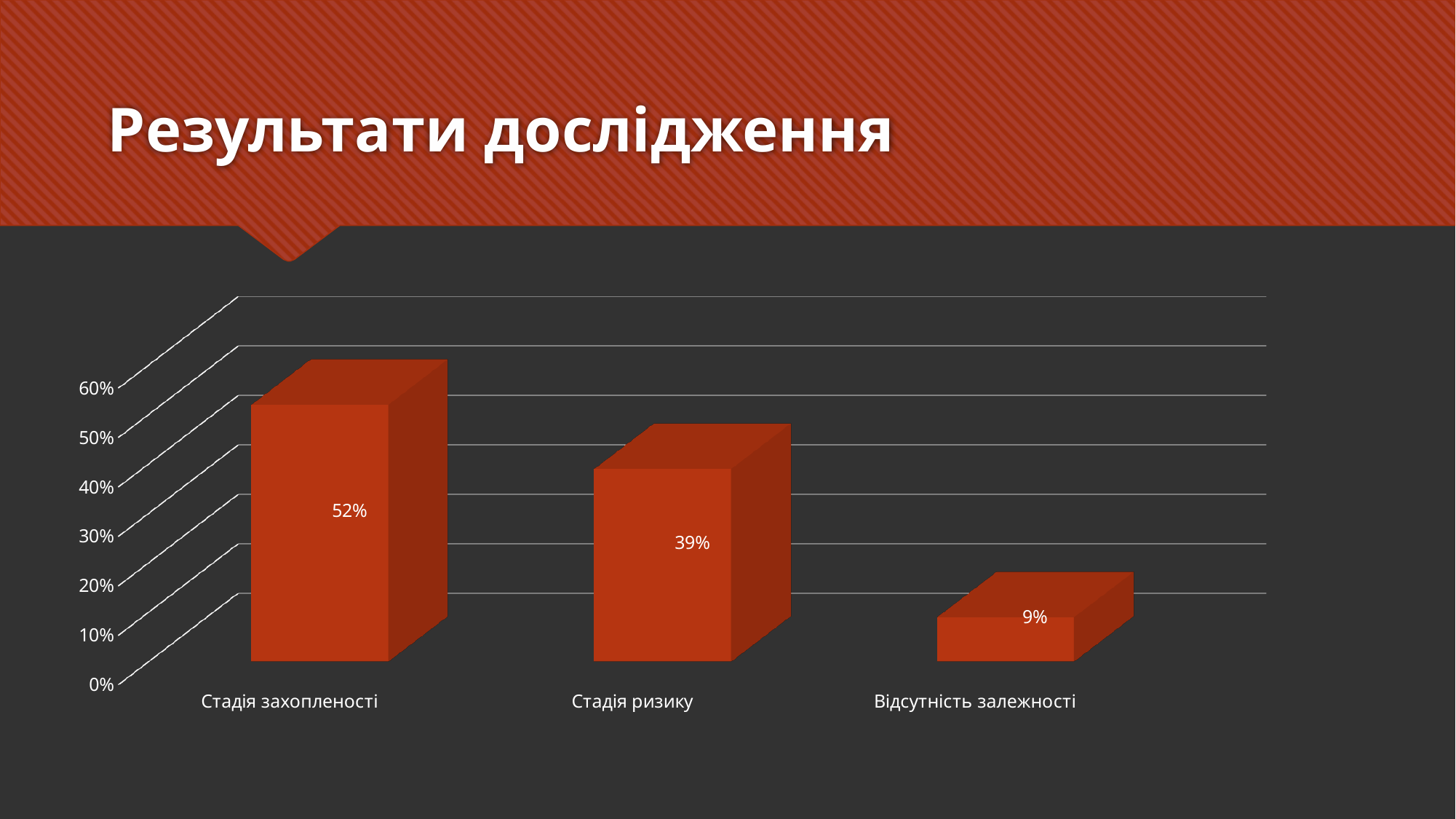
What is the difference between the values for Стадія ризику and Відсутність залежності? 30% What is the value for Стадія ризику? 39% How many categories are shown in the chart? 3 What kind of chart is shown on the slide? bar chart Which category has the lowest value? Відсутність залежності Is the value for Стадія захопленості greater or less than 50%? greater What is the difference between the values for Стадія захопленості and Стадія ризику? 13% Which is larger, the value for Стадія ризику or the value for Відсутність залежності? Стадія ризику Do the values rise or fall from left to right across the categories? fall What is the value for Стадія захопленості? 52% Which category has the highest value? Стадія захопленості What is the value for Відсутність залежності? 9%